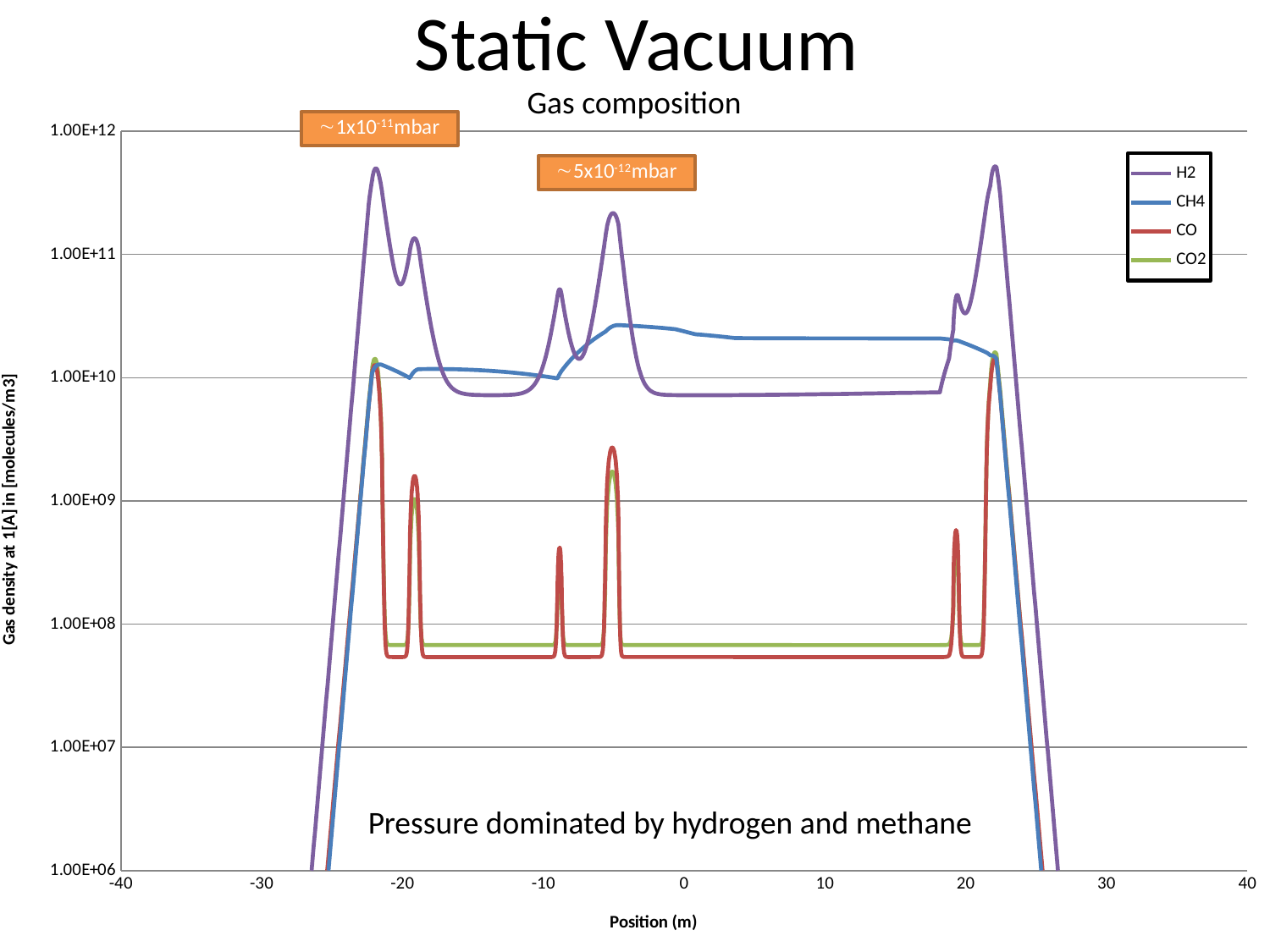
Is the value of CO at position 0 greater or less than 1.00E+08? less Is the peak value of H2 near position 22 greater or less than 1.00E+11? greater What is the label of the x axis? Position (m) Is the value of CO2 at position 10 greater or less than 1.00E+09? less Which series reaches the highest gas density anywhere on the chart? H2 At position 0, which series has the higher gas density, H2 or CH4? CH4 What is the title of the chart? Gas composition Which series has the lowest gas density at position 0? CO What kind of chart is shown on the slide? Line chart How many series does the legend list? 4 At position 0, which series has the higher gas density, CO or CO2? CO2